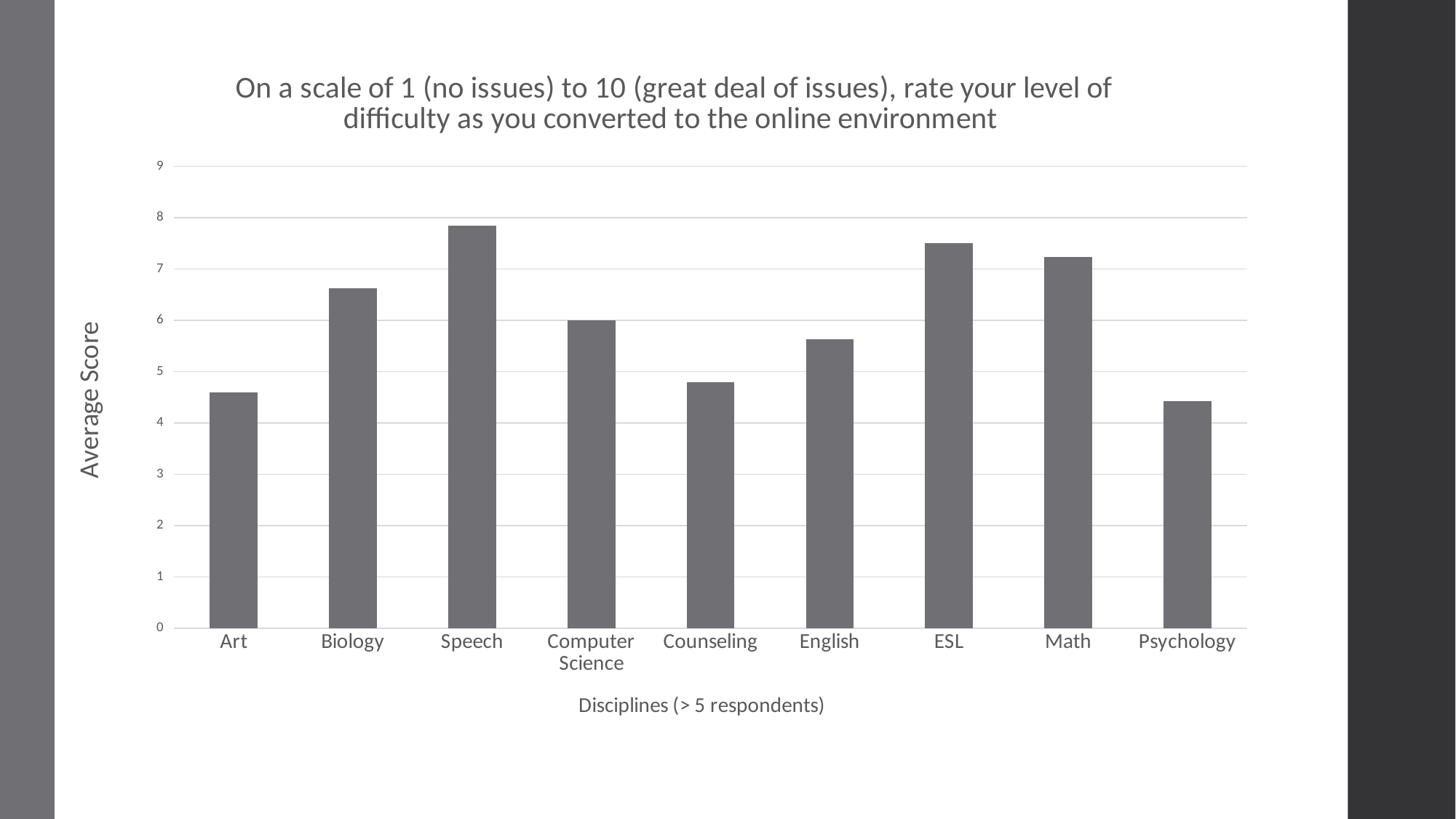
Is the average score for Counseling greater or less than 5? less How many disciplines are shown on the x axis? 9 Is the average score for Biology greater or less than 6? greater What kind of chart is shown on the slide? bar chart What is the title of the horizontal axis? Disciplines (> 5 respondents) Which has a lower average score, Art or Biology? Art Is the average score for Speech greater or less than 7? greater Which has a higher average score, Math or English? Math Which discipline has the highest average score? Speech What is the title of the vertical axis? Average Score